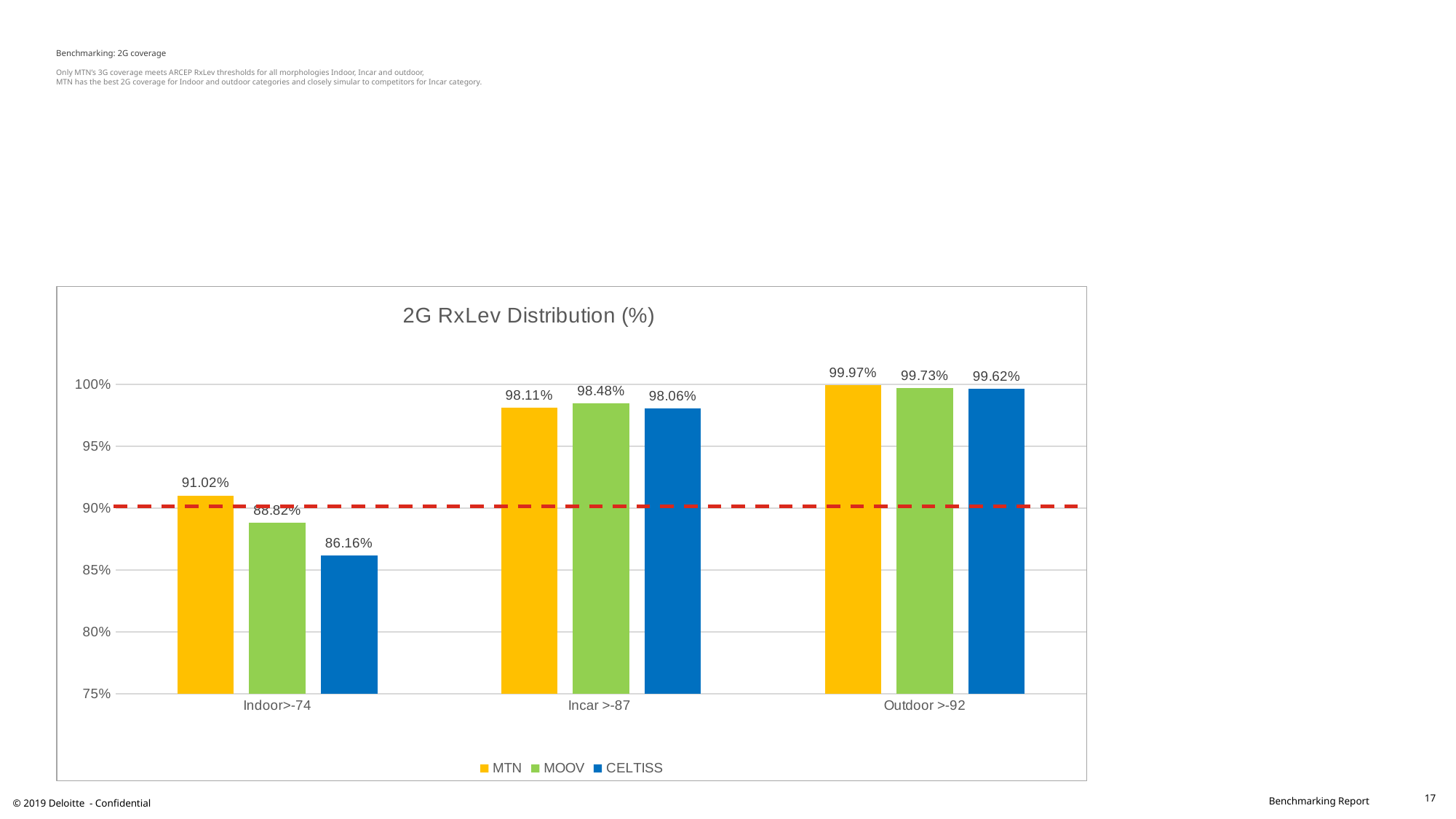
What is the value for MOOV in the Incar >-87 category? 98.48% Which is larger: the MOOV value for Indoor>-74 or the MOOV value for Incar >-87? Incar >-87 How many categories are shown on the x axis? 3 What is the difference between the MTN and CELTISS values in the Indoor>-74 category? 4.86% Is the value for CELTISS in the Indoor>-74 category greater or less than 90%? less Which series has the lowest value in the Indoor>-74 category? CELTISS What is the value for MTN in the Indoor>-74 category? 91.02% What is the value for CELTISS in the Outdoor >-92 category? 99.62% How many series does the legend list? 3 What is the value for CELTISS in the Indoor>-74 category? 86.16% Which series has the highest value in the Indoor>-74 category? MTN What type of chart is shown on the slide? Bar chart